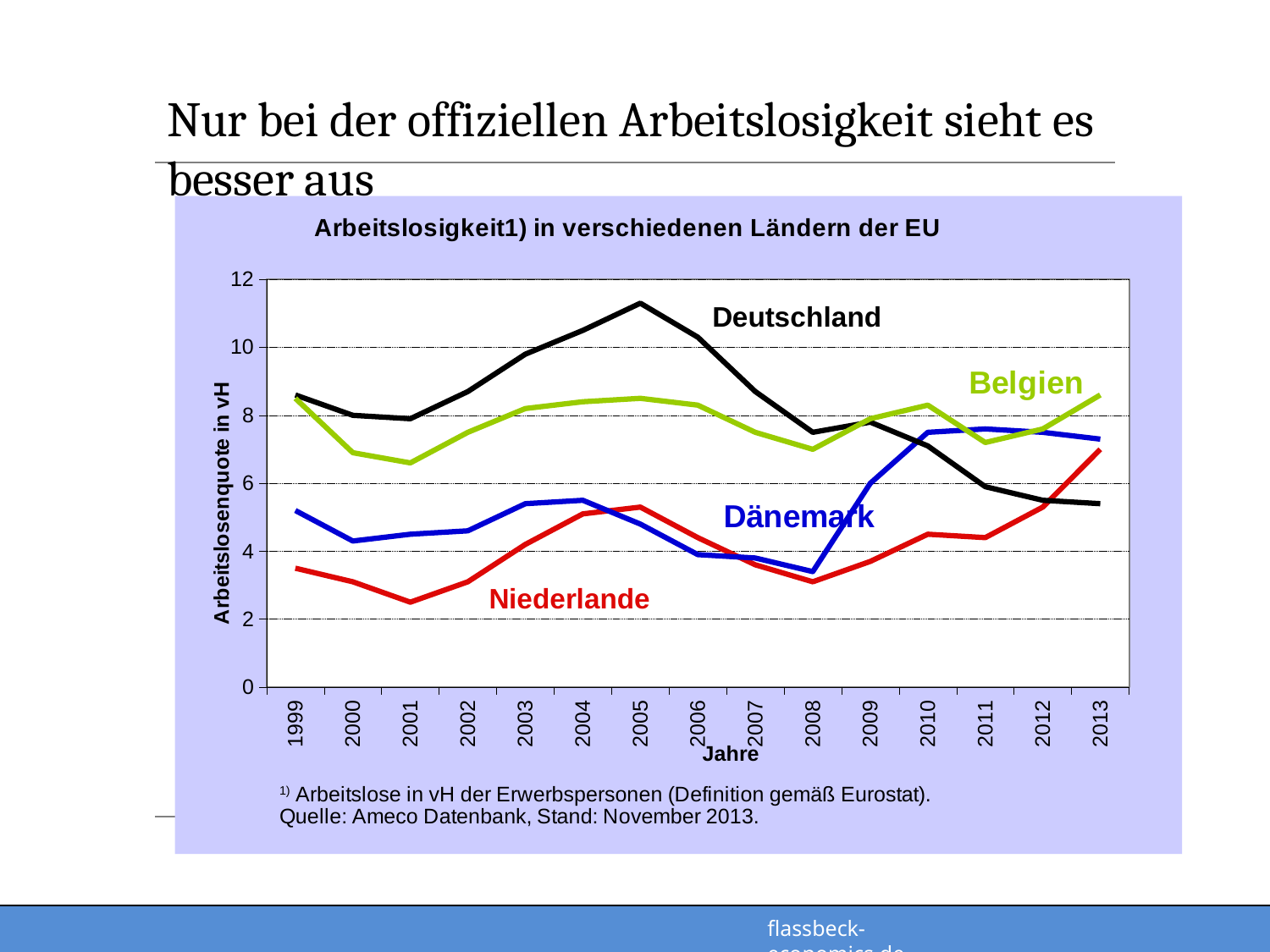
In which year does the Niederlande line reach its lowest value? 2001 Is the value for Deutschland in 2013 greater or less than 6? less Which country has the lowest unemployment rate in 2001? Niederlande Is the value for Niederlande in 2001 greater or less than 4? less Is the value for Deutschland in 2005 greater or less than 10? greater How many countries are plotted as lines in the chart? 4 In 2013, which has the higher value: Deutschland or Belgien? Belgien Which country has the highest unemployment rate in 2005? Deutschland Does the Deutschland line rise or fall from 2005 to 2013? fall What kind of chart is shown on the slide? line chart How many years are shown on the x axis of the chart? 15 In which year does the Deutschland line reach its highest value? 2005